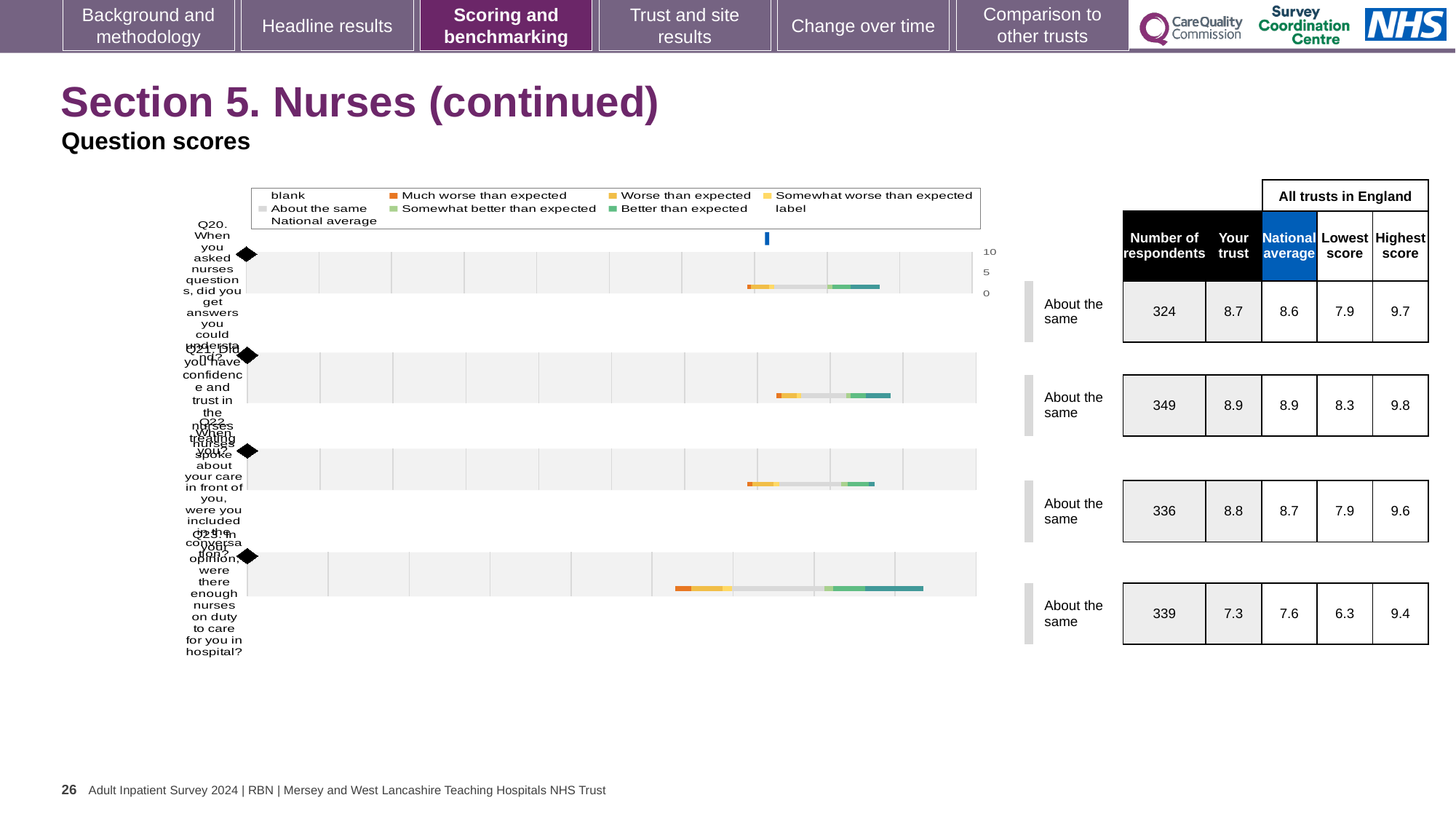
Which question has the lowest 'Your trust' score in the table? Q23 For Q23, what is the difference between the highest score (9.4) and the lowest score (6.3) across all trusts in England? 3.1 How many questions (Q20 to Q23) have a benchmark bar plotted on the slide? 4 Which question has the highest number of respondents in the table? Q21 According to the table, what is the national average score for Q23 (enough nurses on duty)? 7.6 For Q23, which is larger: the 'Your trust' score or the national average? national average According to the table, how many respondents answered Q22 (nurses spoke about your care in front of you)? 336 In the chart legend, which colour represents 'Much worse than expected'? orange What benchmark category is shown next to each of the four question bars? About the same What kind of chart is used to show the question scores on this slide? bar chart What is the highest tick value shown on the score axis of the top chart? 10 According to the table, what is the 'Your trust' score for Q20 (answers you could understand)? 8.7